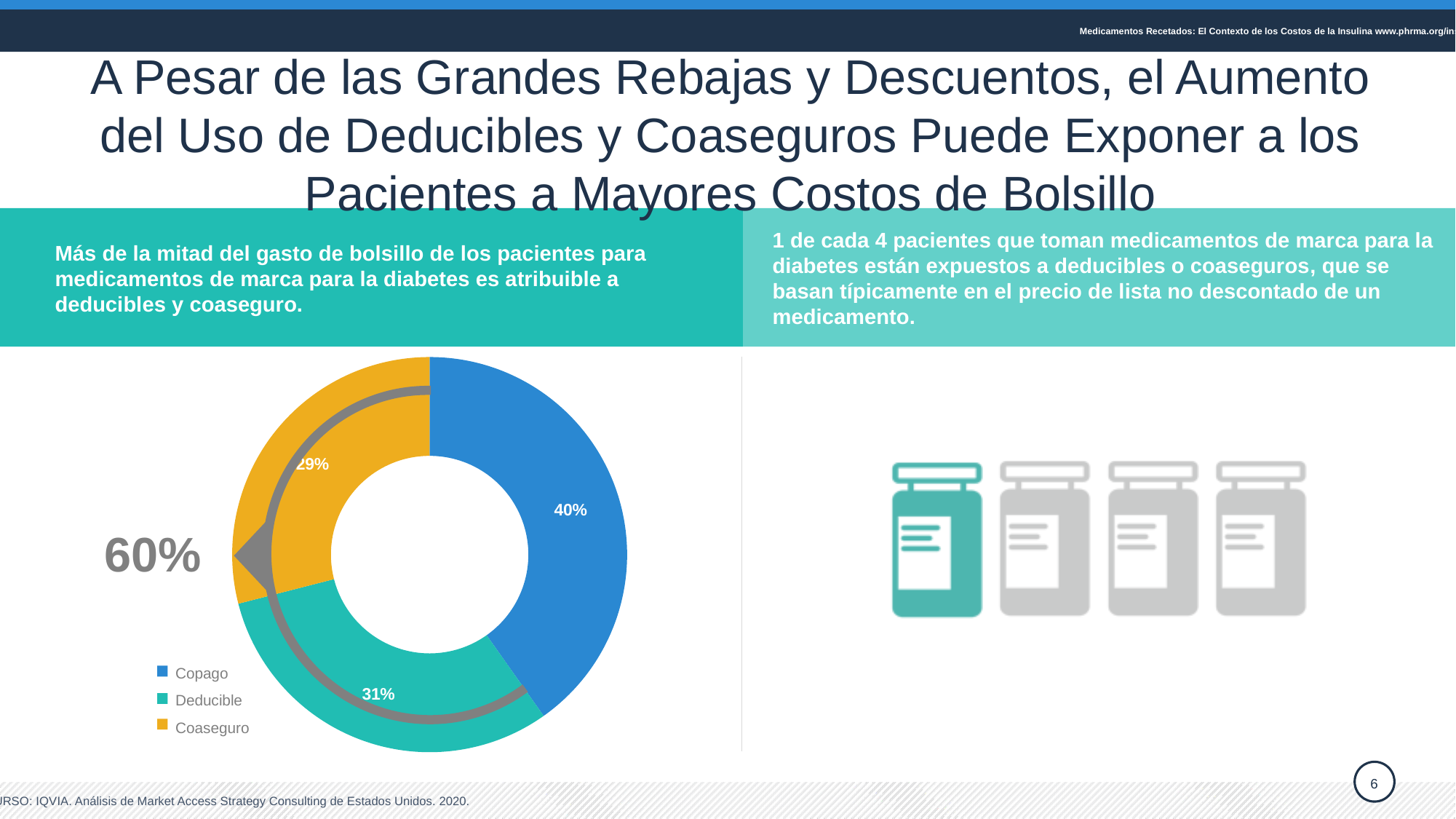
Which category has the largest share in the donut chart? Copago How many categories does the donut chart's legend list? 3 What percentage of out-of-pocket spending is attributed to Copago in the donut chart? 40% What percentage does the Deducible slice show in the donut chart? 31% What kind of chart is shown on the left side of the slide? Donut (pie) chart What colour represents Coaseguro in the donut chart? Orange/yellow What is the combined share of Deducible and Coaseguro in the donut chart? 60% What colour represents Copago in the donut chart? Blue Which is larger in the donut chart, the Copago share or the Deducible share? Copago What is the difference between the Copago share and the Coaseguro share in the donut chart? 11% Which category has the smallest share in the donut chart? Coaseguro What percentage does the Coaseguro slice show in the donut chart? 29%